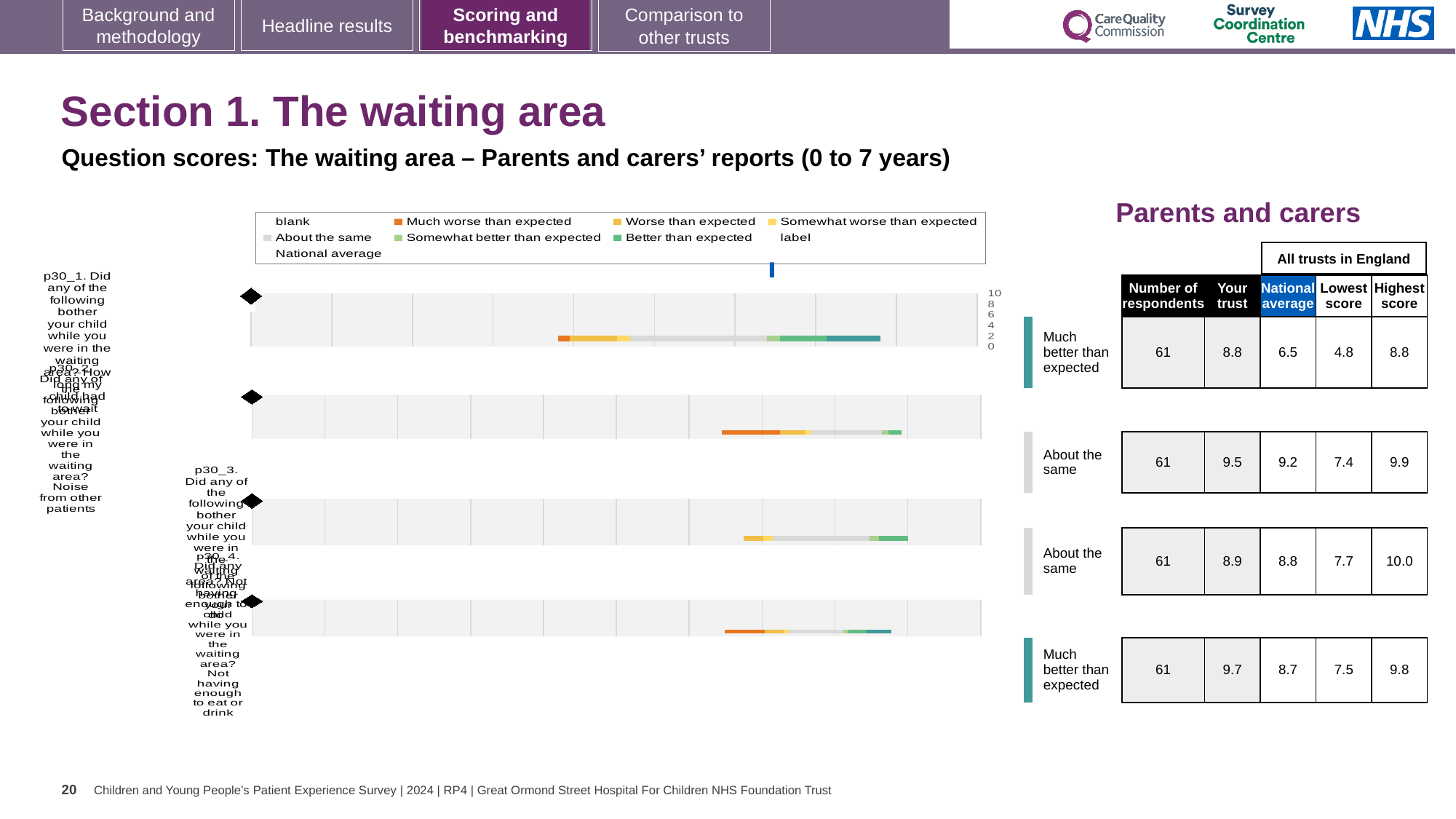
How many entries does the chart legend list? 9 In the table beside the chart, what is the 'Highest score' for the third row? 10.0 In the table beside the chart, what is the 'National average' for the first (top) row? 6.5 In the table beside the chart, what is the difference between 'Your trust' and 'National average' for the first (top) row? 2.3 How many horizontal bars (question rows) does the chart show? 4 In the table beside the chart, which row has the lowest 'Lowest score'? the first (top) row, 4.8 What is the highest value shown on the chart's axis? 10 What kind of chart is shown on the slide? bar chart In the table beside the chart, is 'Your trust' or 'National average' larger for the second row? Your trust In the table beside the chart, how many respondents are listed for each row? 61 In the table beside the chart, which row has the highest 'Your trust' score? the fourth (bottom) row, 9.7 In the table beside the chart, what is the 'Your trust' score for the first (top) row? 8.8